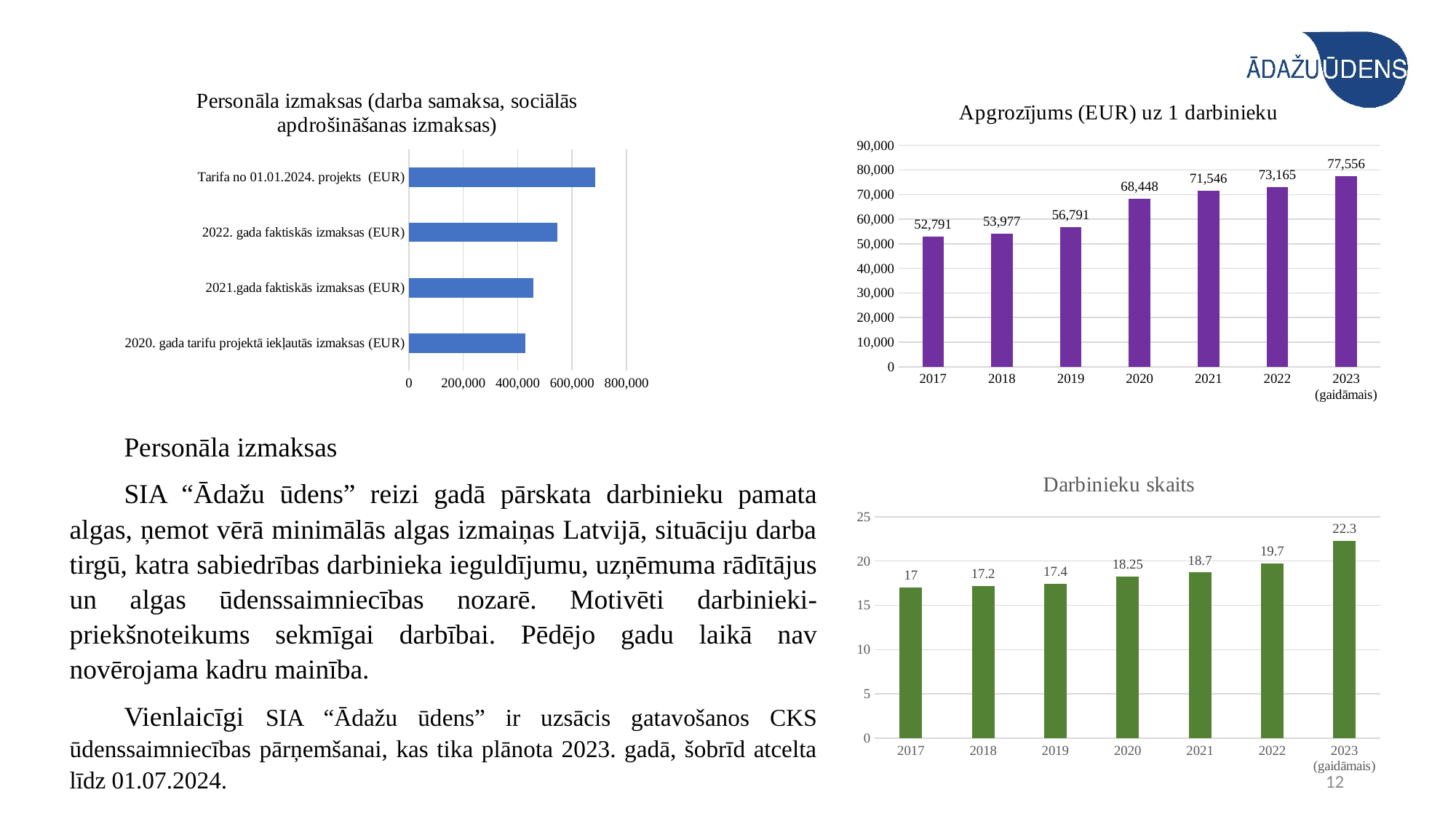
In the chart 'Personāla izmaksas (darba samaksa, sociālās apdrošināšanas izmaksas)', which category has the longest bar? Tarifa no 01.01.2024. projekts (EUR) In the chart 'Darbinieku skaits', how many years are shown on the x axis? 7 In the chart 'Personāla izmaksas (darba samaksa, sociālās apdrošināšanas izmaksas)', is the value for '2022. gada faktiskās izmaksas (EUR)' greater or less than 600,000? less In the chart 'Apgrozījums (EUR) uz 1 darbinieku', which year has the highest value? 2023 (gaidāmais) In the chart 'Darbinieku skaits', what is the value for 2021? 18.7 In the chart 'Apgrozījums (EUR) uz 1 darbinieku', do the values rise or fall from 2017 to 2023? rise In the chart 'Darbinieku skaits', which year has the lowest value? 2017 In the chart 'Darbinieku skaits', what is the difference between the 2023 (gaidāmais) value and the 2017 value? 5.3 In the chart 'Personāla izmaksas (darba samaksa, sociālās apdrošināšanas izmaksas)', how many categories are shown? 4 What kind of chart is 'Personāla izmaksas (darba samaksa, sociālās apdrošināšanas izmaksas)'? bar chart In the chart 'Apgrozījums (EUR) uz 1 darbinieku', what is the value for 2020? 68,448 In the chart 'Apgrozījums (EUR) uz 1 darbinieku', what is the difference between the 2023 (gaidāmais) value and the 2017 value? 24,765